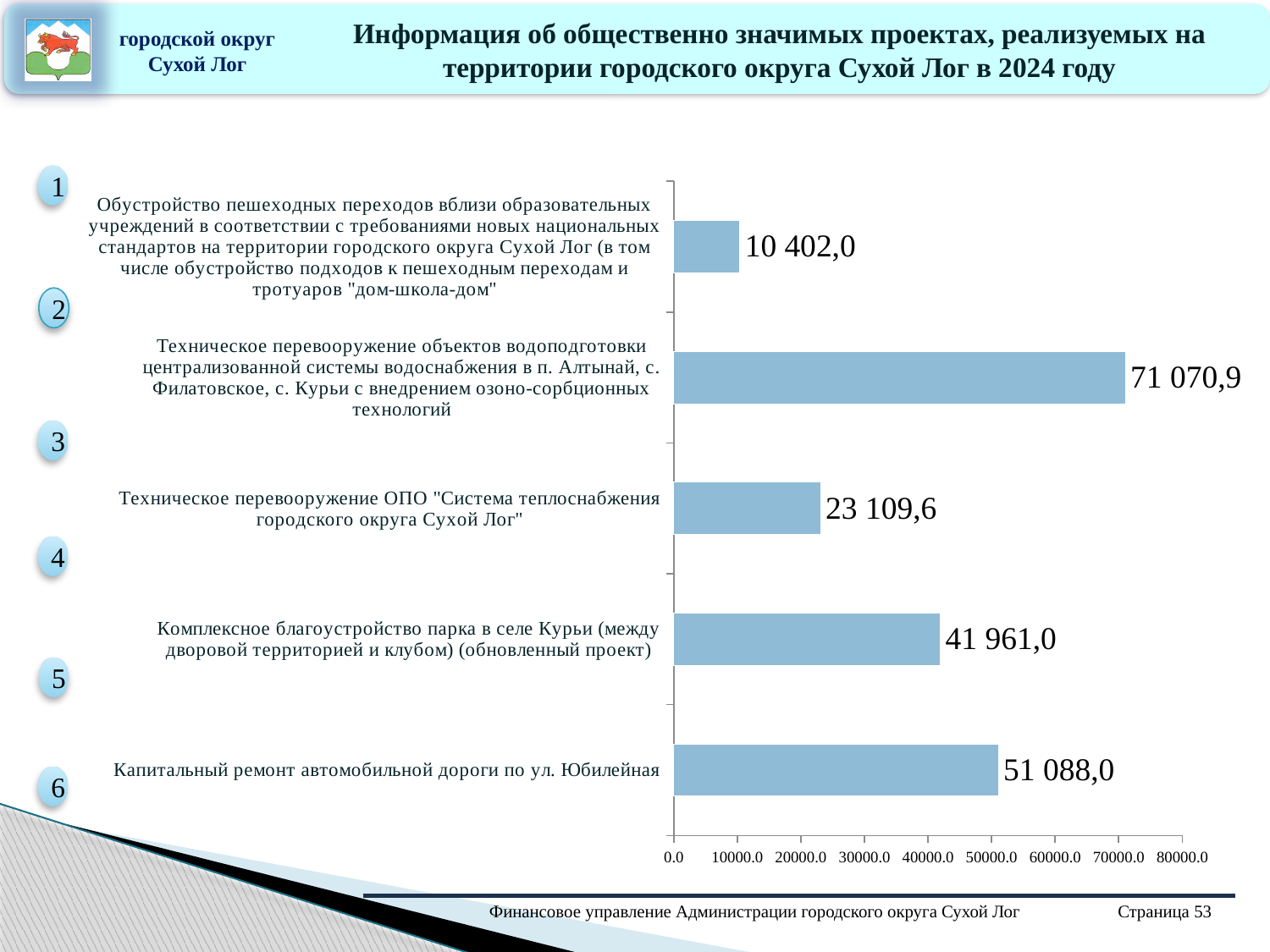
What is the value for «Комплексное благоустройство парка в селе Курьи (между дворовой территорией и клубом) (обновленный проект)»? 41 961,0 Which project has the lowest value on the chart? Обустройство пешеходных переходов вблизи образовательных учреждений в соответствии с требованиями новых национальных стандартов на территории городского округа Сухой Лог What is the difference between the highest value (71 070,9) and the lowest value (10 402,0) on the chart? 60 668,9 What is the value for the project on arranging pedestrian crossings near educational institutions (Обустройство пешеходных переходов вблизи образовательных учреждений)? 10 402,0 Which project has the highest value on the chart? Техническое перевооружение объектов водоподготовки централизованной системы водоснабжения в п. Алтынай, с. Филатовское, с. Курьи с внедрением озоно-сорбционных технологий What is the value for «Техническое перевооружение ОПО "Система теплоснабжения городского округа Сухой Лог"»? 23 109,6 What type of chart is shown on the slide? bar chart Which is larger: the value for «Техническое перевооружение ОПО "Система теплоснабжения"» or the value for «Комплексное благоустройство парка в селе Курьи»? Комплексное благоустройство парка в селе Курьи What is the value for «Капитальный ремонт автомобильной дороги по ул. Юбилейная»? 51 088,0 Is the value for «Капитальный ремонт автомобильной дороги по ул. Юбилейная» greater or less than 50000? greater How many projects (bars) are shown on the chart? 5 What is the difference between the value for «Капитальный ремонт автомобильной дороги по ул. Юбилейная» and the value for «Комплексное благоустройство парка в селе Курьи»? 9 127,0